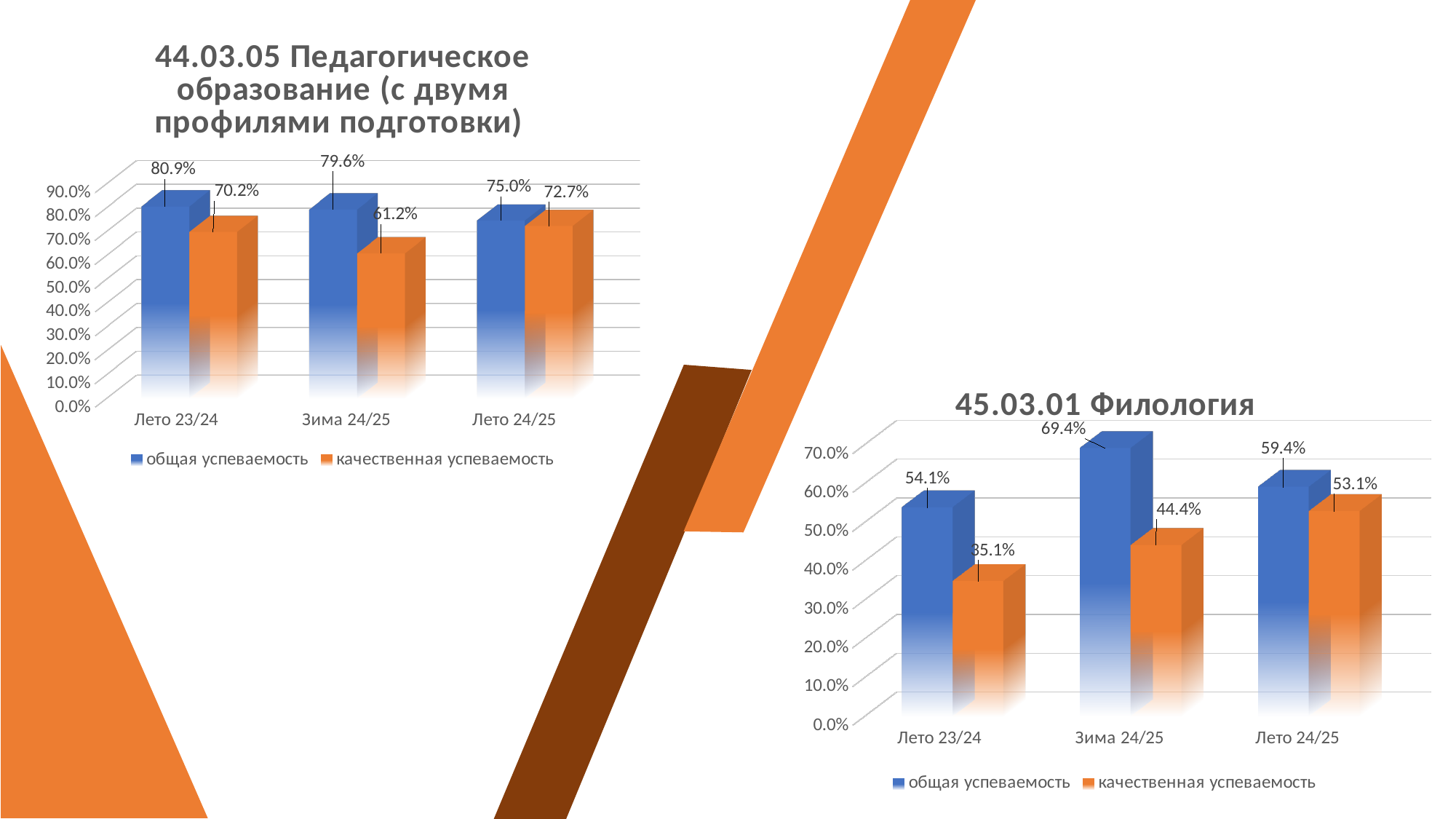
In the chart titled "45.03.01 Филология", which is larger: качественная успеваемость for Зима 24/25 or for Лето 24/25? Лето 24/25 How many series does the legend of the chart titled "45.03.01 Филология" list? 2 What kind of chart is the chart titled "44.03.05 Педагогическое образование (с двумя профилями подготовки)"? bar chart In the chart titled "45.03.01 Филология", what is the value of качественная успеваемость for Лето 23/24? 35.1% In the chart titled "45.03.01 Филология", what is the value of общая успеваемость for Зима 24/25? 69.4% In the chart titled "45.03.01 Филология", which period has the lowest качественная успеваемость? Лето 23/24 In the chart titled "44.03.05 Педагогическое образование (с двумя профилями подготовки)", what is the value of качественная успеваемость for Зима 24/25? 61.2% In the chart titled "45.03.01 Филология", what is the difference between общая успеваемость and качественная успеваемость for Лето 24/25? 6.3% In the chart titled "44.03.05 Педагогическое образование (с двумя профилями подготовки)", what is the value of общая успеваемость for Лето 23/24? 80.9% In the chart titled "44.03.05 Педагогическое образование (с двумя профилями подготовки)", what is the difference between общая успеваемость and качественная успеваемость for Зима 24/25? 18.4% In the chart titled "44.03.05 Педагогическое образование (с двумя профилями подготовки)", does общая успеваемость rise or fall from Лето 23/24 to Лето 24/25? fall In the chart titled "44.03.05 Педагогическое образование (с двумя профилями подготовки)", which period has the highest качественная успеваемость? Лето 24/25